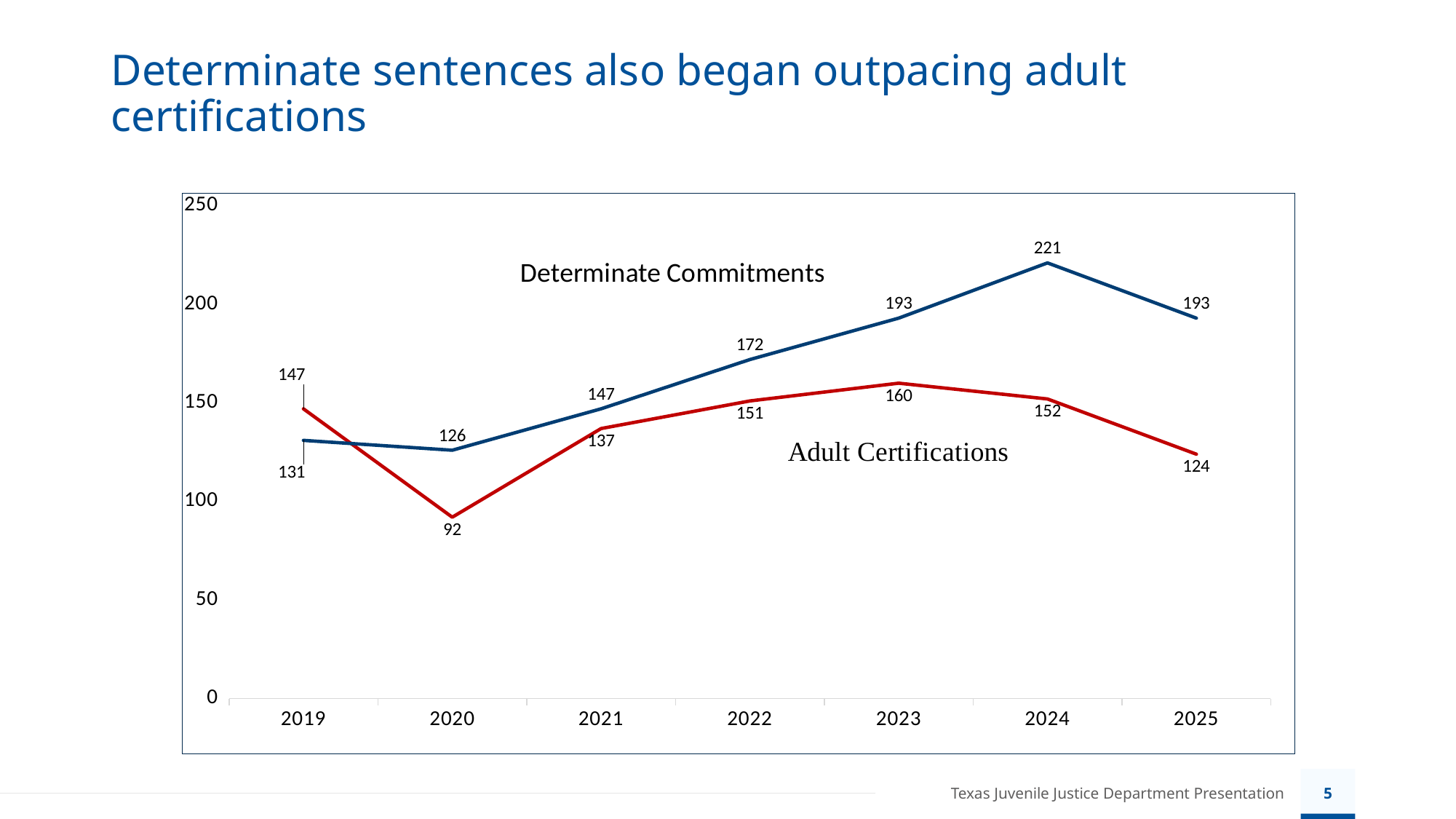
What is the value for Determinate Commitments in 2024? 221 Do Determinate Commitments rise or fall from 2020 to 2024? rise What is the value for Adult Certifications in 2020? 92 In which year do Determinate Commitments reach their highest value? 2024 What is the value for Adult Certifications in 2025? 124 How many data series are plotted on the chart? 2 In which year are Adult Certifications at their lowest? 2020 What is the difference between Determinate Commitments and Adult Certifications in 2024? 69 What is the value for Determinate Commitments in 2019? 131 What kind of chart is shown on the slide? line chart Which series has the higher value in 2019, Determinate Commitments or Adult Certifications? Adult Certifications How many years are shown on the x axis? 7